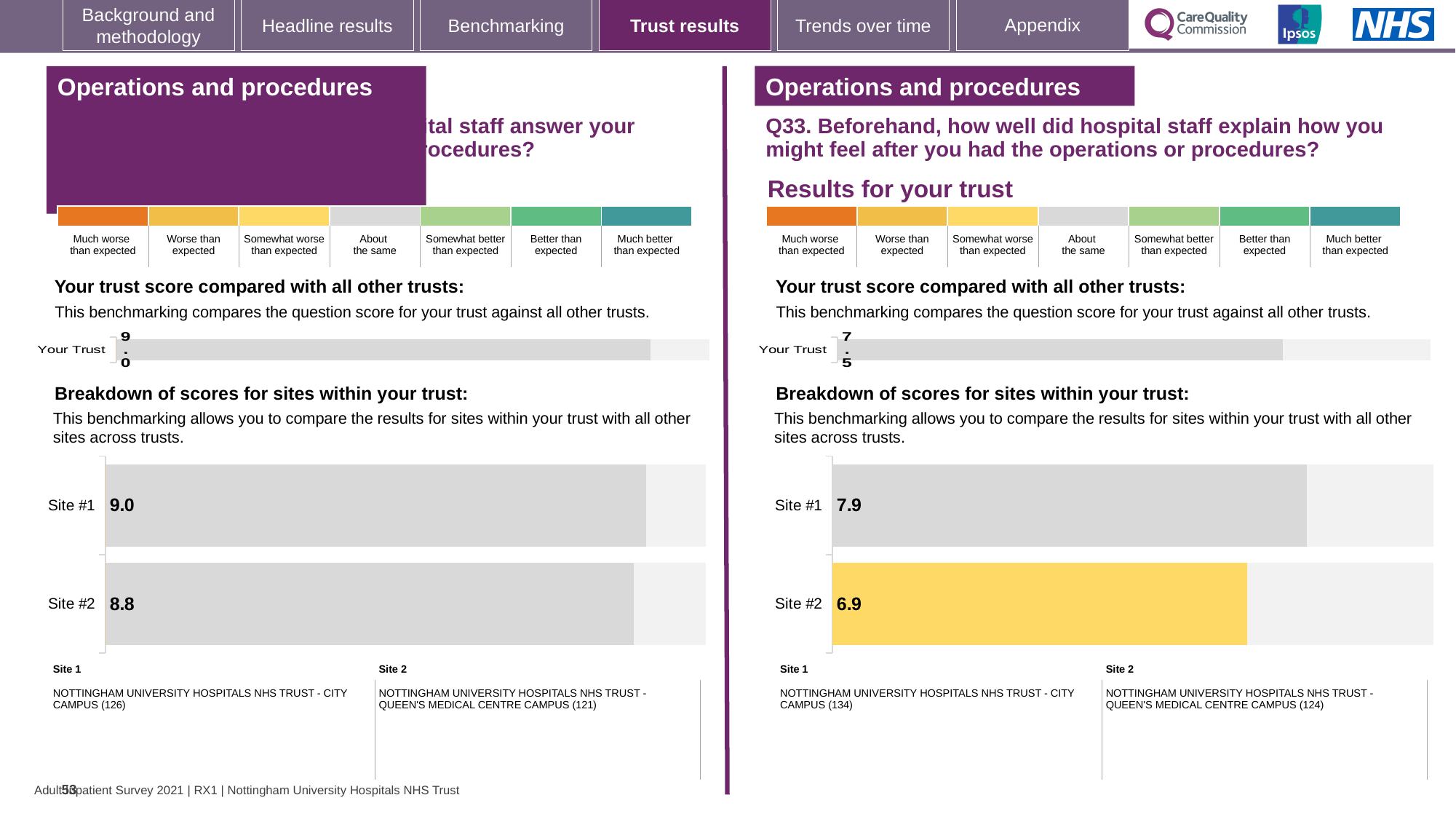
On the right-hand (Q33) site breakdown chart, what is the difference between the Site #1 and Site #2 scores? 1.0 On the left-hand site breakdown chart, what is the score for Site #1? 9.0 On the right-hand (Q33) 'Your trust score compared with all other trusts' chart, what is the score shown for Your Trust? 7.5 On the right-hand (Q33) site breakdown chart, which site has the lower score? Site #2 On the left-hand site breakdown chart, what is the score for Site #2? 8.8 On the left-hand site breakdown chart, what is the difference between the Site #1 and Site #2 scores? 0.2 On the left-hand 'Your trust score compared with all other trusts' chart, what is the score shown for Your Trust? 9.0 On the right-hand (Q33) site breakdown chart, what is the score for Site #1? 7.9 How many sites are shown on the right-hand (Q33) site breakdown chart? 2 On the right-hand (Q33) site breakdown chart, what is the score for Site #2? 6.9 What kind of chart is the right-hand (Q33) site breakdown chart? Bar chart On the left-hand site breakdown chart, which site has the higher score, Site #1 or Site #2? Site #1